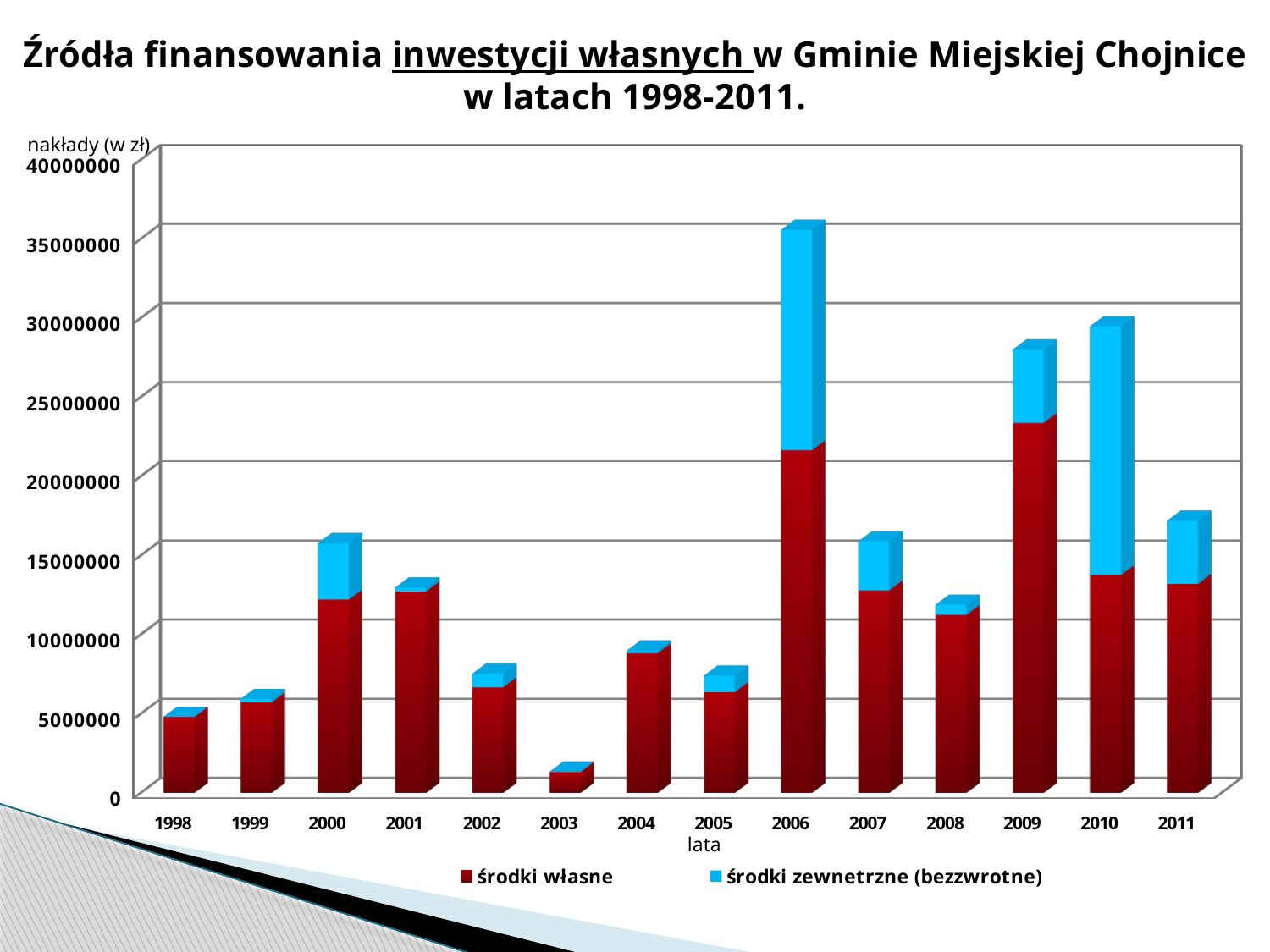
How many series does the legend list? 2 Which year has the highest total bar? 2006 Is the 'środki własne' value for 2010 greater or less than 15000000? less What are the two series named in the legend? środki własne; środki zewnetrzne (bezzwrotne) Is the total value for 2003 greater or less than 5000000? less Which year has the lowest total bar? 2003 How many years (categories) are shown on the x axis? 14 Which year has the larger total bar, 2001 or 2002? 2001 Is the total value for 2006 greater or less than 30000000? greater What kind of chart is shown on the slide? Stacked bar chart Which year has the larger total bar, 2006 or 2009? 2006 Which year has the largest 'środki własne' (own funds) segment? 2009